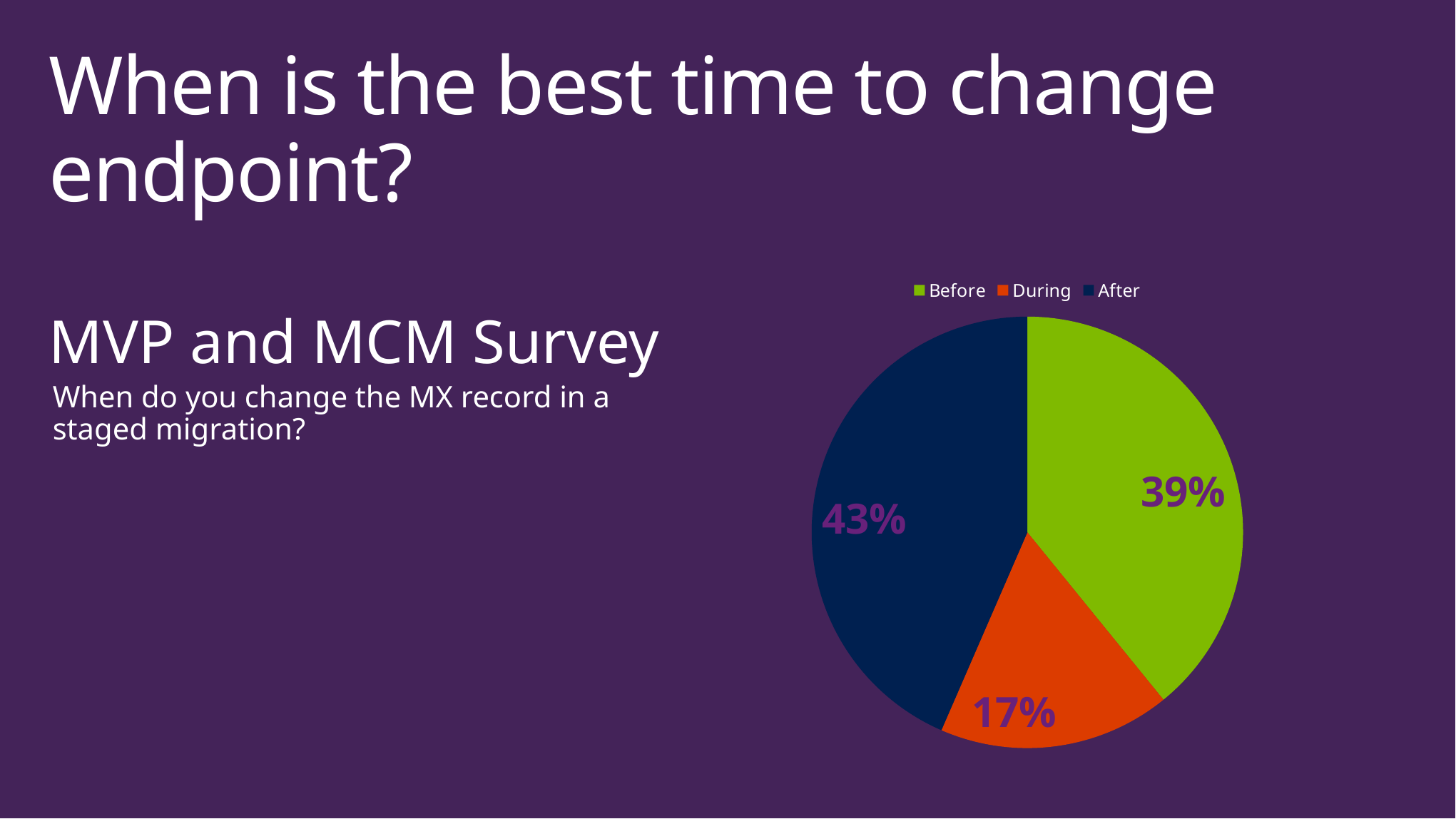
Which slice is larger, Before or During? Before How many entries does the legend list? 3 Which option has the smallest share of the pie? During What percentage of respondents change the MX record after the migration? 43% What percentage of respondents change the MX record during the migration? 17% What is the difference in percentage points between the Before and During slices? 22 How many slices does the pie chart have? 3 Which option has the largest share of the pie? After What percentage of respondents change the MX record before the migration? 39% What is the difference in percentage points between the After and Before slices? 4 What kind of chart is shown on the slide? pie chart What colour is the After slice in the pie chart? dark navy blue